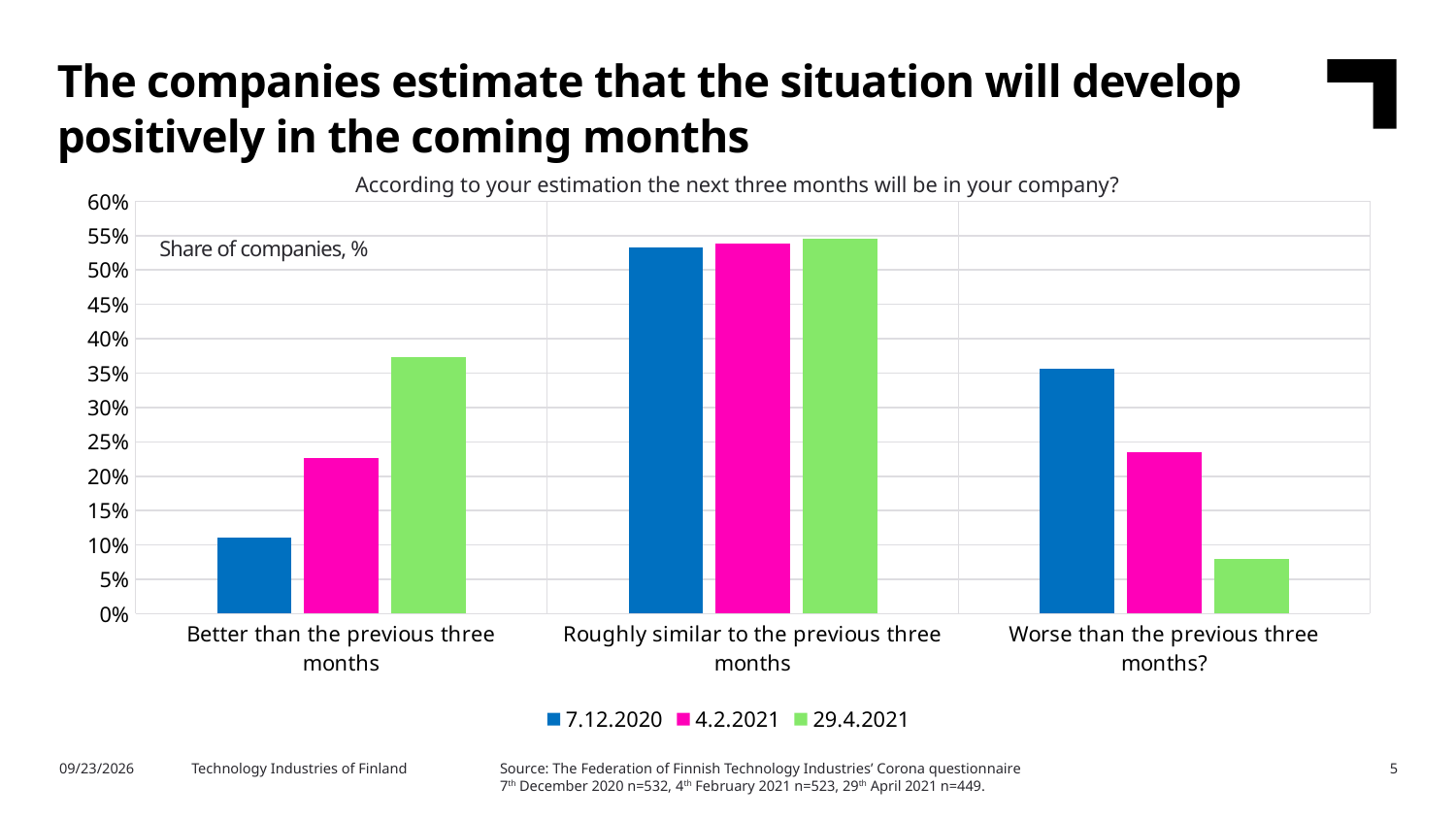
Which survey date has the lowest value in the 'Worse than the previous three months?' category? 29.4.2021 In the 'Worse than the previous three months?' category, which is larger: the value for 7.12.2020 or for 4.2.2021? 7.12.2020 In the 'Better than the previous three months' category, which is larger: the value for 4.2.2021 or for 29.4.2021? 29.4.2021 Is the value for 29.4.2021 in the 'Better than the previous three months' category greater or less than 35%? greater How many series does the legend list? 3 How many response categories are shown on the x axis? 3 Is the value for 7.12.2020 in the 'Worse than the previous three months?' category greater or less than 30%? greater Is the value for 29.4.2021 in the 'Worse than the previous three months?' category greater or less than 10%? less Across the three survey dates from 7.12.2020 to 29.4.2021, do the values for 'Better than the previous three months' rise or fall? rise What kind of chart is shown on the slide? bar chart Which survey date has the highest value in the 'Better than the previous three months' category? 29.4.2021